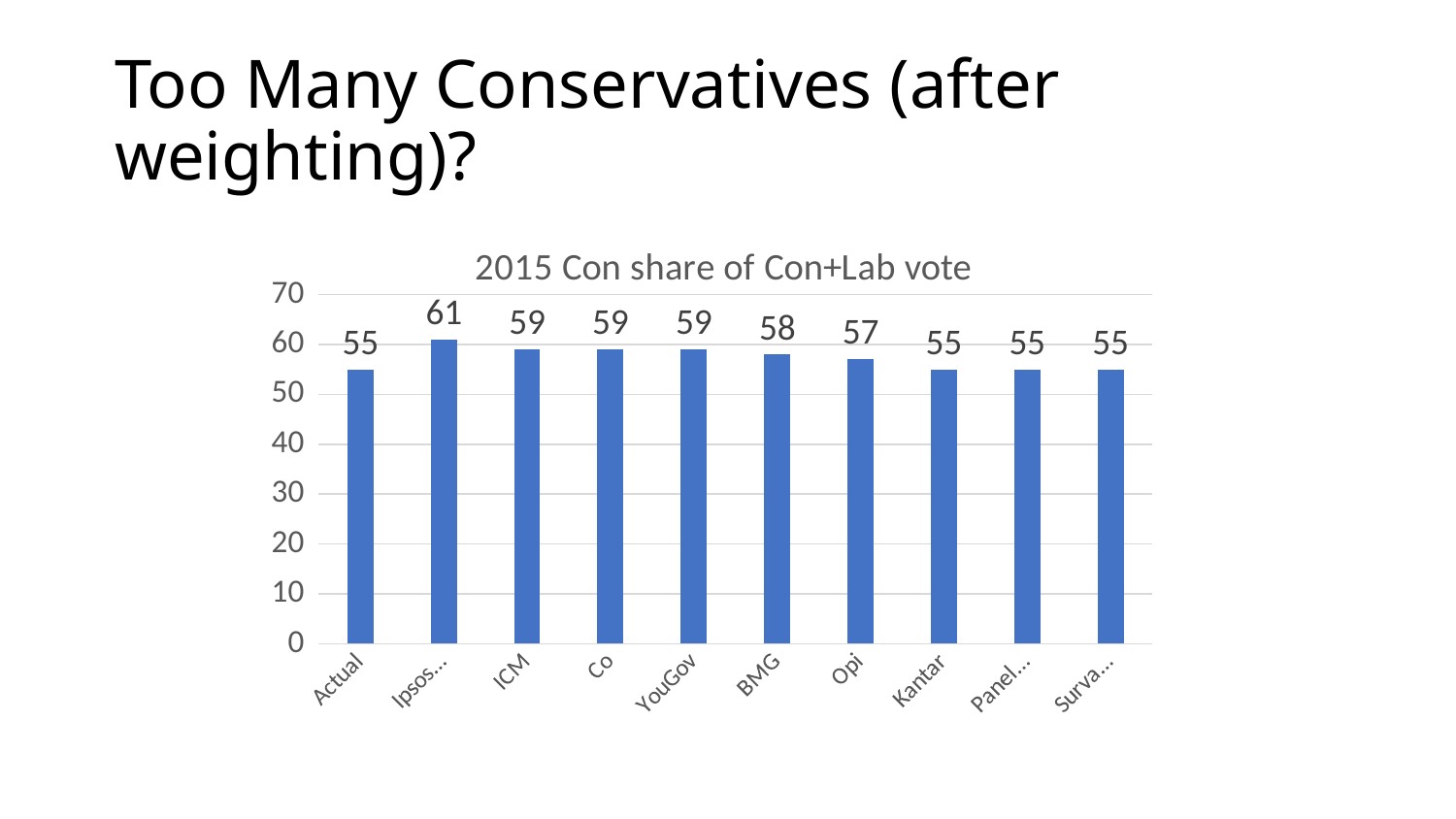
Which is larger, the value for BMG or the value for Opi? BMG What is the title of the chart? 2015 Con share of Con+Lab vote What is the difference between the values for YouGov and Actual? 4 What kind of chart is shown on the slide? Bar chart What is the highest value shown on the chart? 61 How many bars are shown on the chart? 10 What is the value for Actual? 55 Is the value for Opi greater or less than 50? greater What is the value for Kantar? 55 What is the value for BMG? 58 What is the value for ICM? 59 What is the value for YouGov? 59